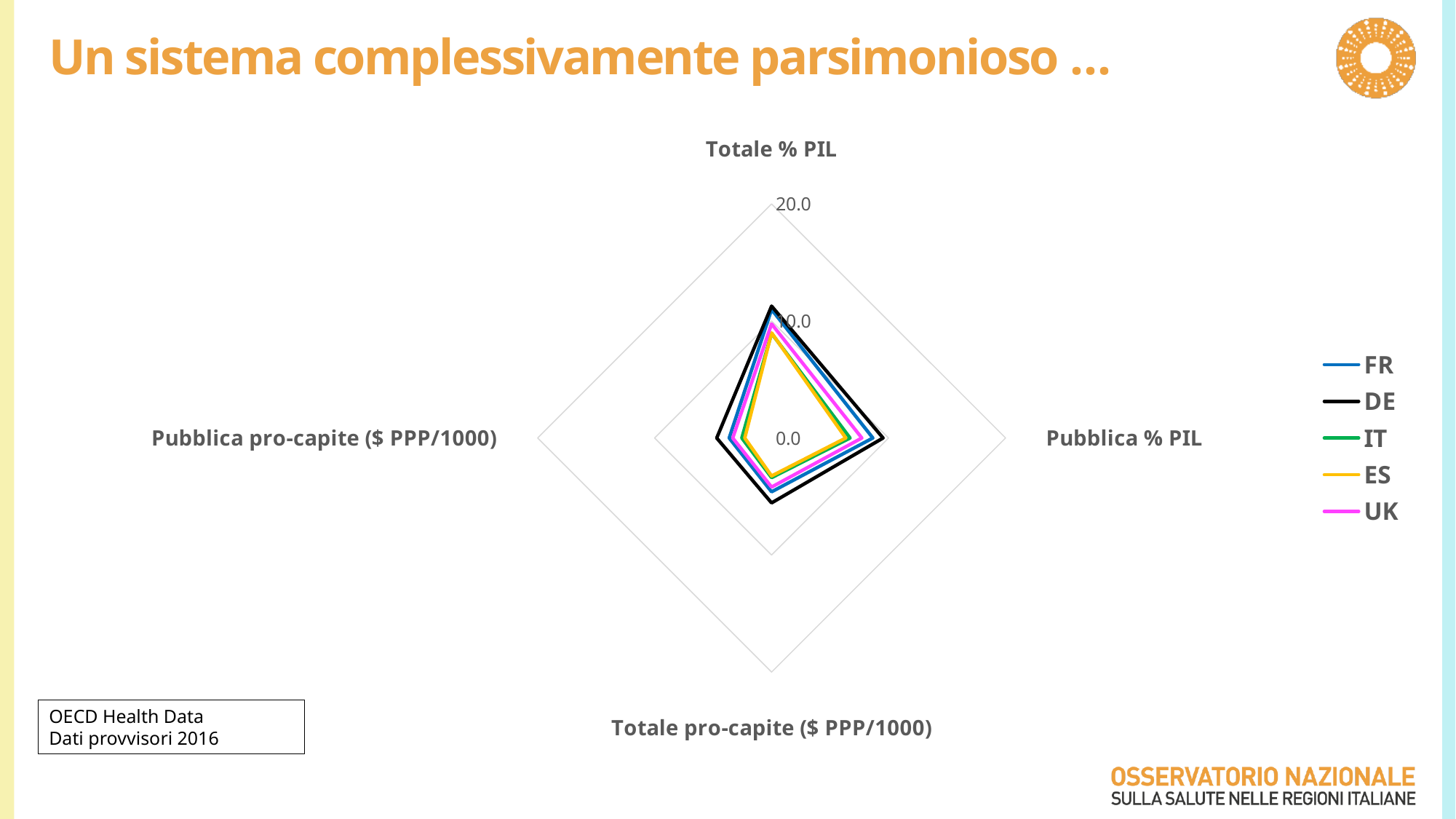
How many series does the legend list? 5 Is the value for DE on the Totale pro-capite ($ PPP/1000) axis greater or less than 10.0? less What kind of chart is shown on the slide? Radar chart Which colour represents DE in the legend? Black Which country has the highest value on the Totale pro-capite ($ PPP/1000) axis? DE What is the maximum value shown on the radar chart's scale? 20.0 Which is larger on the Totale % PIL axis, the value for DE or the value for ES? DE Which country has the highest value on the Totale % PIL axis? DE Is the value for DE on the Totale % PIL axis greater or less than 20.0? less Is the value for ES on the Totale % PIL axis greater or less than 10.0? less Which country has the highest value on the Pubblica pro-capite ($ PPP/1000) axis? DE How many axes (categories) does the radar chart have? 4